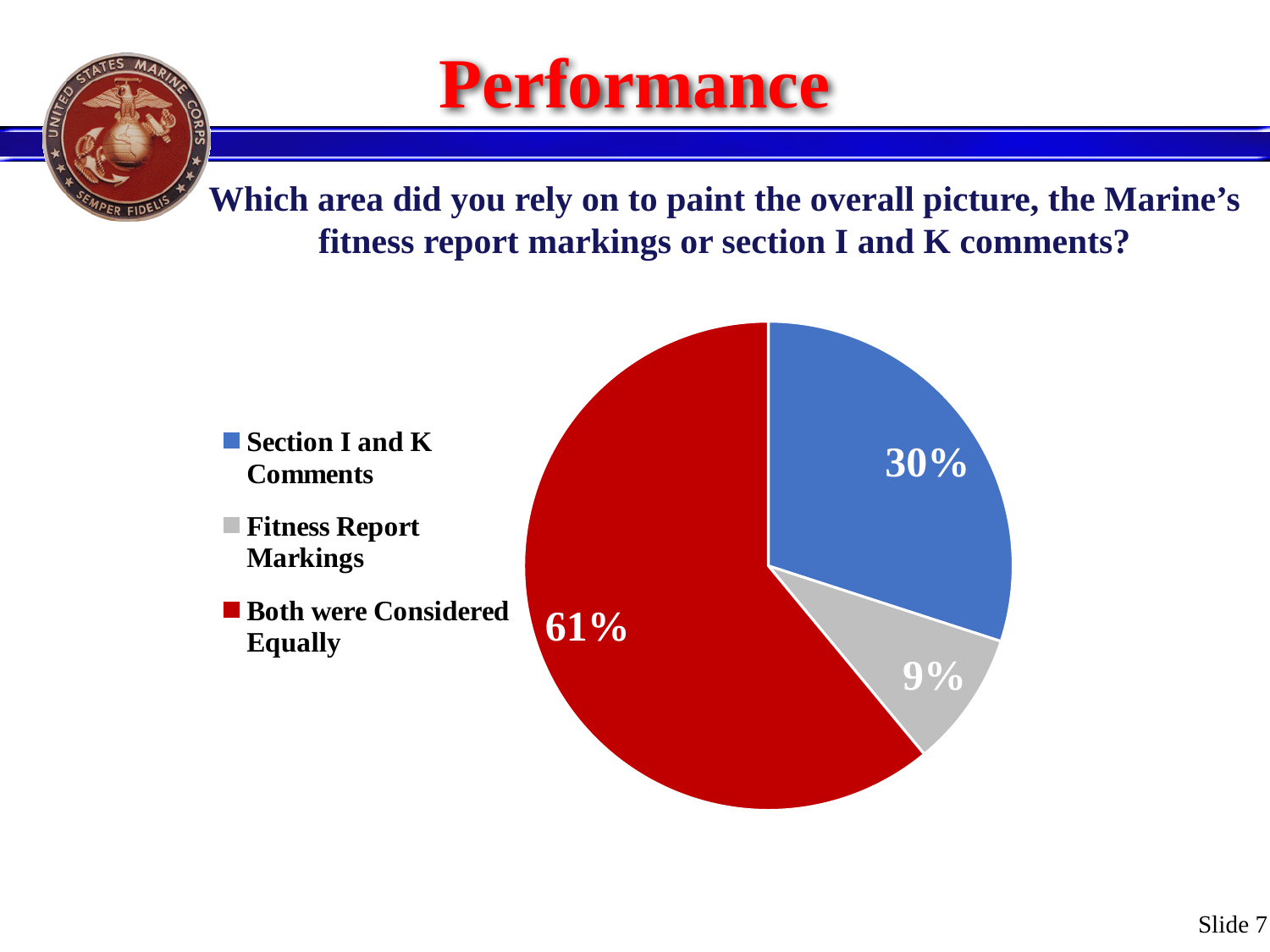
What kind of chart is shown on the slide? pie chart What is the difference in percentage points between Section I and K Comments and Fitness Report Markings? 21 What percentage of respondents said Both were Considered Equally? 61% What colour is the slice for Both were Considered Equally? red How many categories does the pie chart show? 3 Which category is shown in grey in the legend? Fitness Report Markings What percentage of respondents relied on Section I and K Comments? 30% Which is larger, the share for Section I and K Comments or the share for Fitness Report Markings? Section I and K Comments What is the difference in percentage points between Both were Considered Equally and Section I and K Comments? 31 Which category has the smallest share of the pie? Fitness Report Markings Which category has the largest share of the pie? Both were Considered Equally What percentage of respondents relied on Fitness Report Markings? 9%